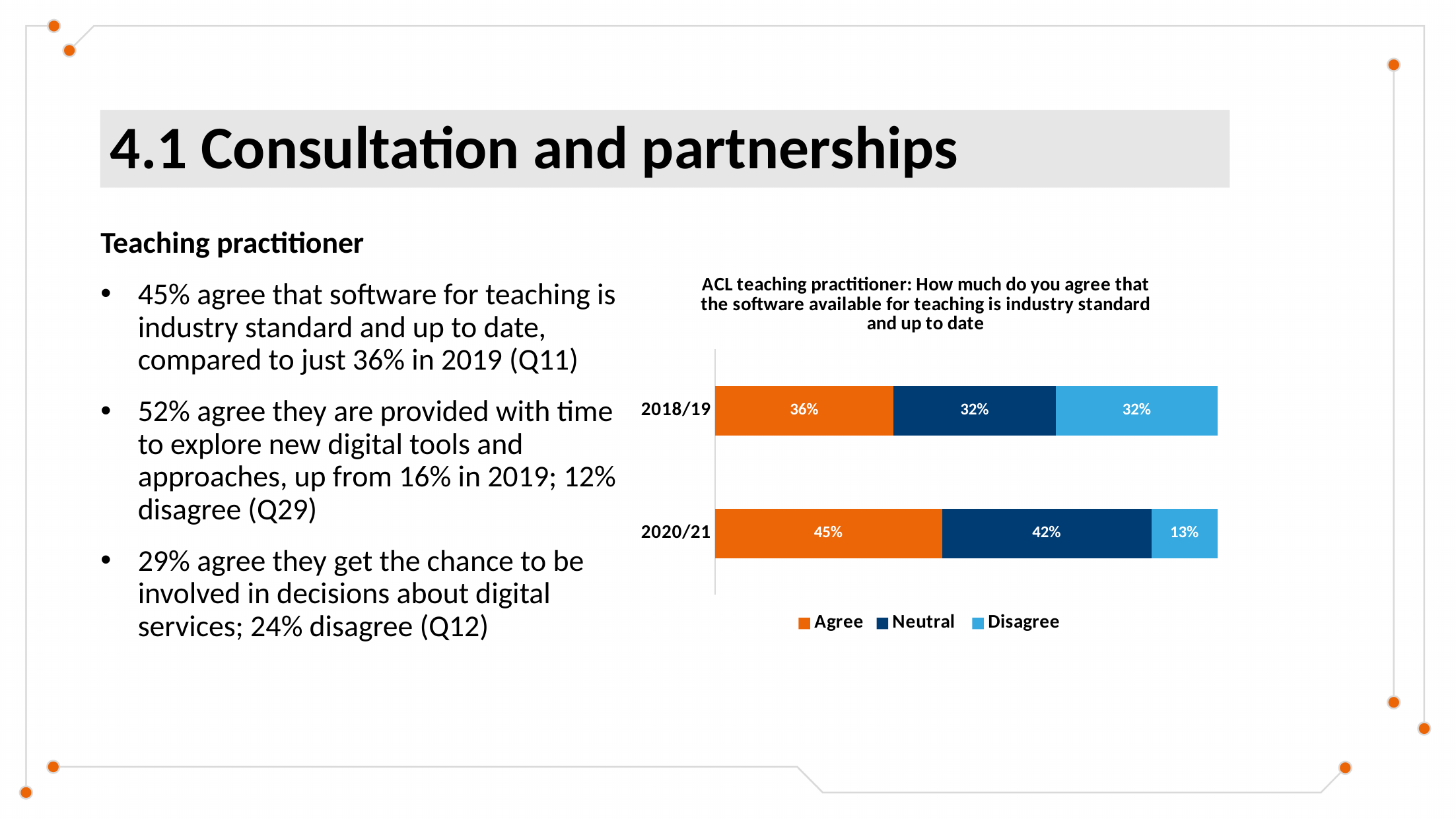
What is the Neutral value for 2018/19 in the chart? 32% What is the Agree value for 2018/19 in the chart? 36% How many categories (years) are shown on the chart? 2 What percentage of ACL teaching practitioners agreed in 2020/21 that the software available for teaching is industry standard and up to date? 45% What type of chart is shown on the slide? Stacked bar chart Which series is shown in orange in the chart? Agree What is the difference between the Agree values for 2020/21 and 2018/19? 9 percentage points By how many percentage points did the Disagree share fall from 2018/19 to 2020/21? 19 percentage points Which response category has the largest share in 2020/21? Agree What is the Disagree value for 2020/21 in the chart? 13% How many series does the chart legend list? 3 Which year has the higher Agree percentage, 2018/19 or 2020/21? 2020/21